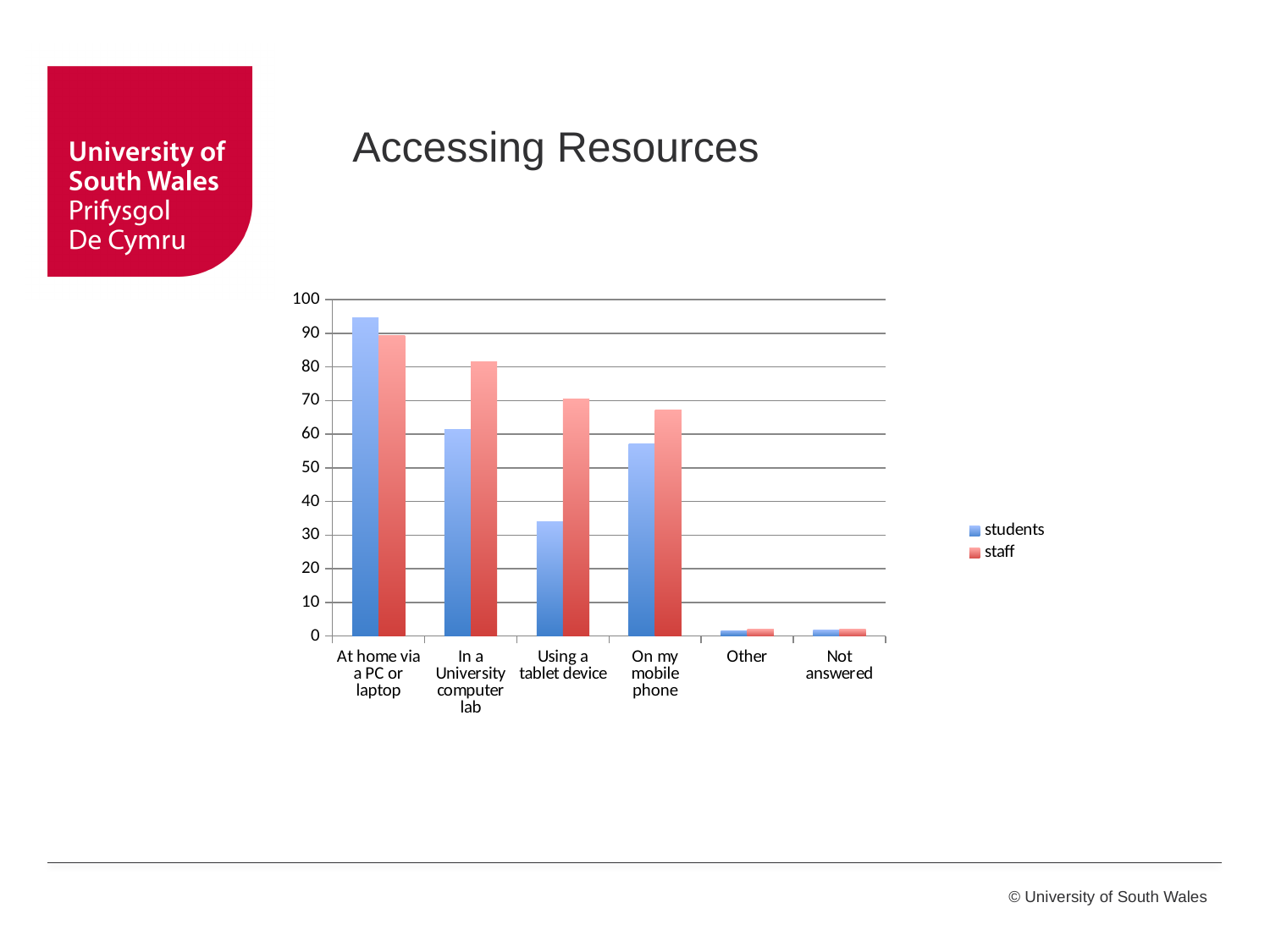
What kind of chart is shown on the slide? bar chart Is the value for staff for 'Using a tablet device' greater or less than 60? greater Is the value for students for 'Using a tablet device' greater or less than 40? less How many series does the legend list? 2 Which category has the highest value for staff? At home via a PC or laptop What colour are the bars for the staff series? red Is the value for students for 'In a University computer lab' greater or less than 50? greater For 'Using a tablet device', which is larger: students or staff? staff Which category has the highest value for students? At home via a PC or laptop For 'At home via a PC or laptop', which is larger: students or staff? students How many categories are shown on the x axis? 6